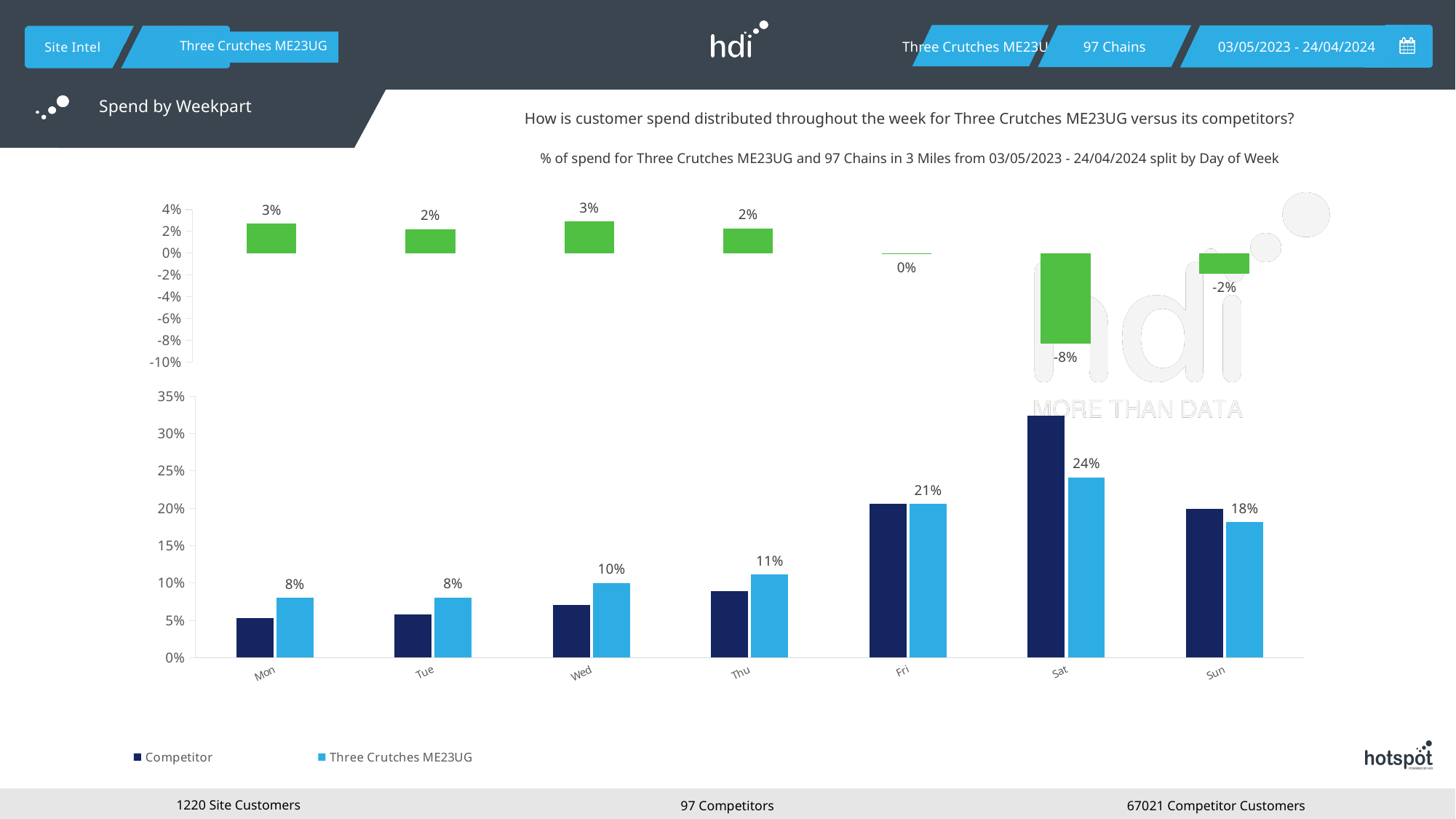
In the bottom chart, what is the difference between the Three Crutches ME23UG values for Sat and Sun? 6% In the bottom chart, is the Competitor value for Mon greater or less than 10%? less In the top chart, which day has the lowest value? Sat What kind of chart is the bottom chart? Bar chart In the bottom chart, is the Competitor value for Sat greater or less than 30%? greater In the bottom chart, what is the value for Three Crutches ME23UG on Sat? 24% In the bottom chart, which day has the highest value for Three Crutches ME23UG? Sat How many series does the legend of the bottom chart list? 2 How many days of the week are shown on the x axis of the bottom chart? 7 In the bottom chart, which is larger on Sat: the Competitor bar or the Three Crutches ME23UG bar? Competitor In the bottom chart, what is the value for Three Crutches ME23UG on Thu? 11% In the top chart, what is the value shown for Sat? -8%